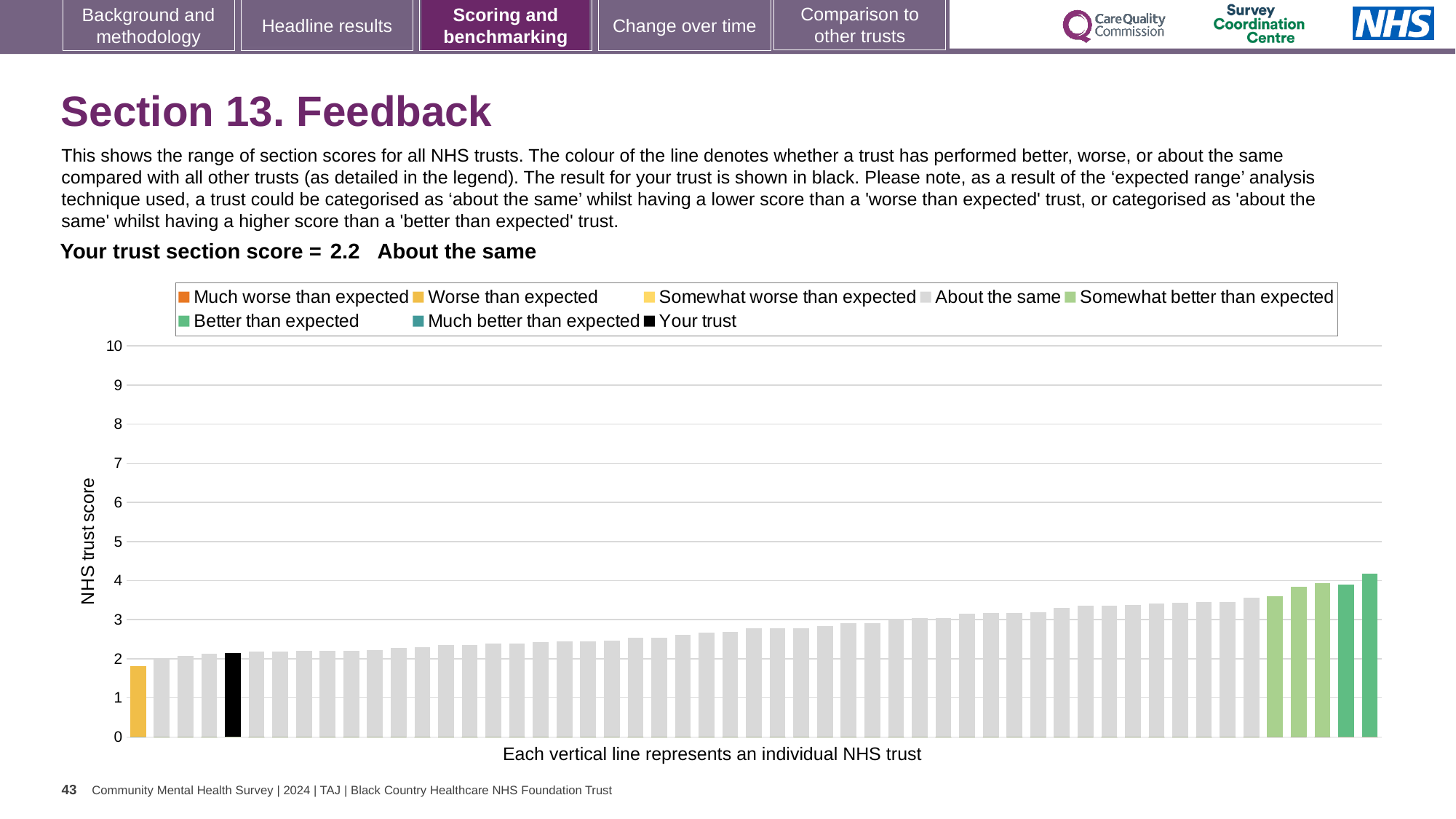
Is the black bar for your trust higher or lower than the tallest green bar? lower What is the label below the horizontal axis? Each vertical line represents an individual NHS trust Is the value of the tallest bar greater or less than 5? less What colour is used in the legend for 'Your trust'? black What is the label on the vertical axis? NHS trust score Is the value for your trust (the black bar) greater or less than 3? less Is the value of the leftmost (yellow) bar greater or less than 2? less Do the bar values rise or fall from left to right along the x axis? rise What kind of chart is shown on the slide? bar chart How many entries does the chart legend list? 8 What is the section score for your trust shown on the slide? 2.2 Which category is your trust's section score placed in? About the same